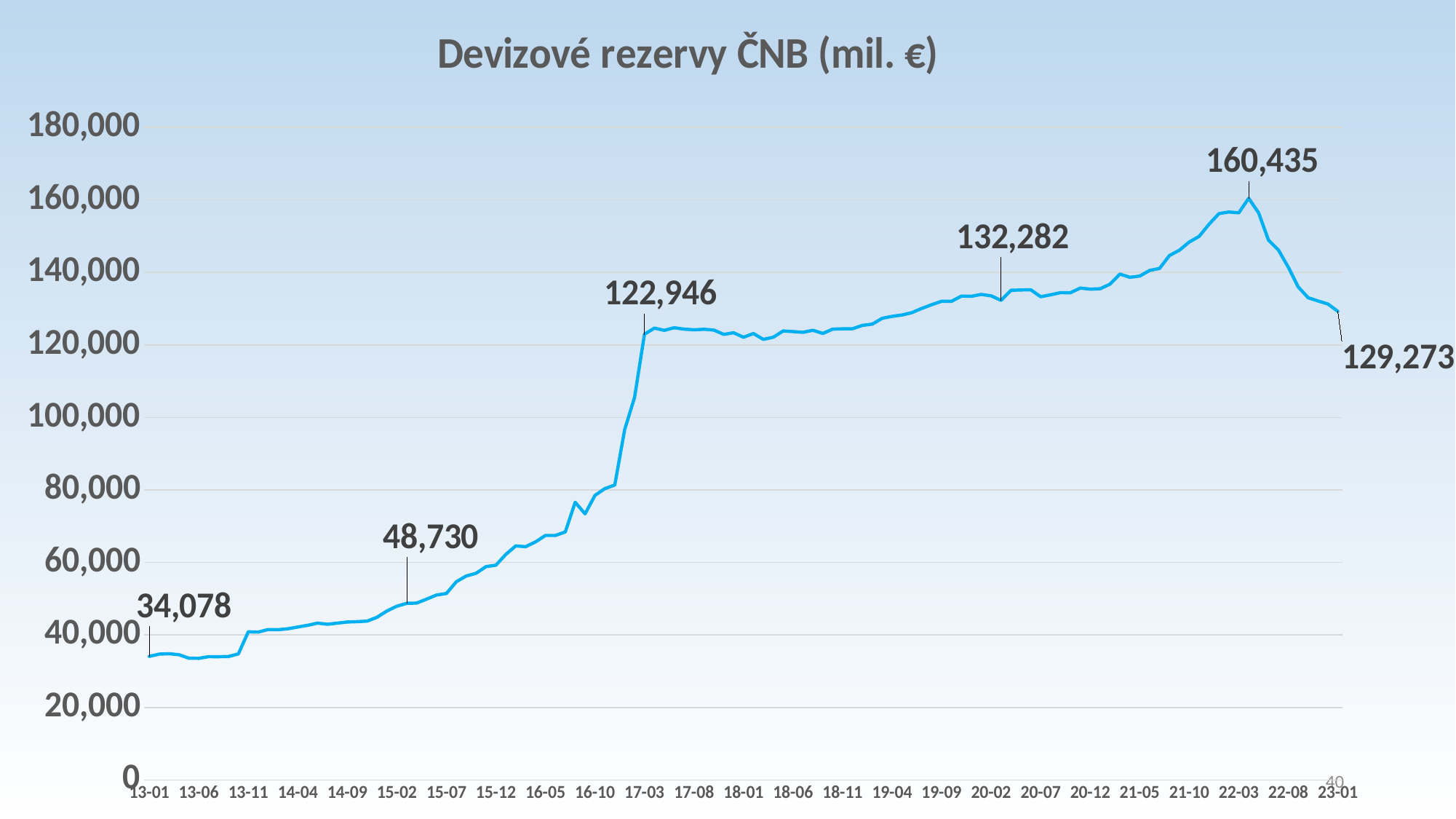
Is the value at 18-06 greater or less than 120,000? greater What is the difference between the peak value 160,435 and the final value 129,273? 31,162 Which is larger, the labelled value at 20-02 or the labelled value at 17-03? 20-02 What is the value labelled at 20-02? 132,282 What is the highest value labelled on the chart? 160,435 What kind of chart is shown on the slide? line chart What is the value of the reserves at 23-01? 129,273 What is the value labelled at 17-03? 122,946 What is the title of the chart? Devizové rezervy ČNB (mil. €) What is the value of the reserves at 13-01? 34,078 By how much did the reserves increase from the labelled value 48,730 to the labelled value 122,946? 74,216 What is the lowest value labelled on the chart? 34,078